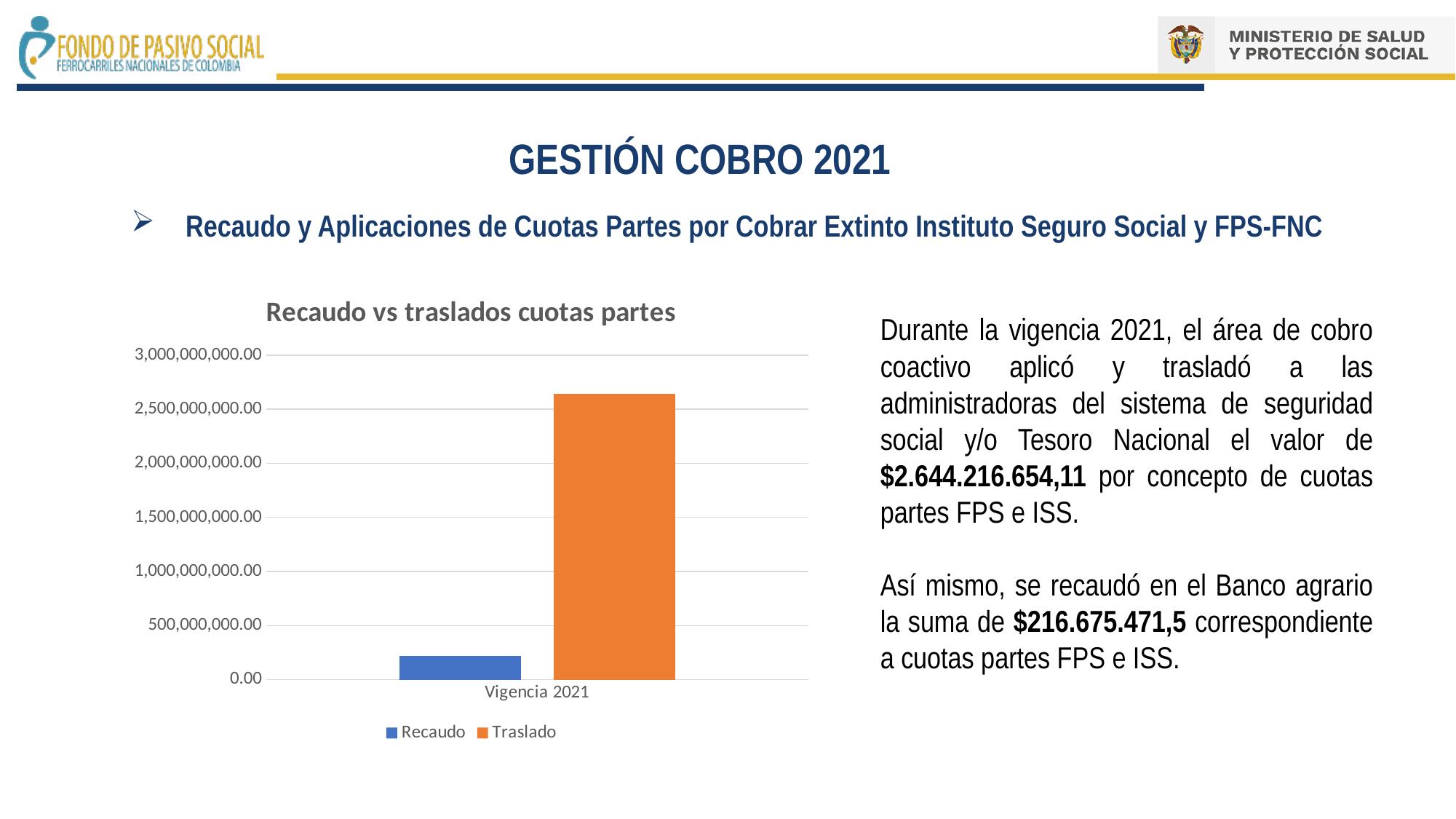
Is the value for Recaudo greater or less than 1,000,000,000.00? less What is the title of the chart? Recaudo vs traslados cuotas partes What kind of chart is shown on the slide? Bar chart Is the value for Traslado greater or less than 2,500,000,000.00? greater Which series has the highest bar in the chart? Traslado Is the value for Traslado greater or less than 3,000,000,000.00? less How many series does the chart legend list? 2 How many categories are shown on the x axis of the chart? 1 Which series has the lowest bar in the chart? Recaudo What is the category label on the x axis of the chart? Vigencia 2021 Which is larger in the chart, Recaudo or Traslado? Traslado